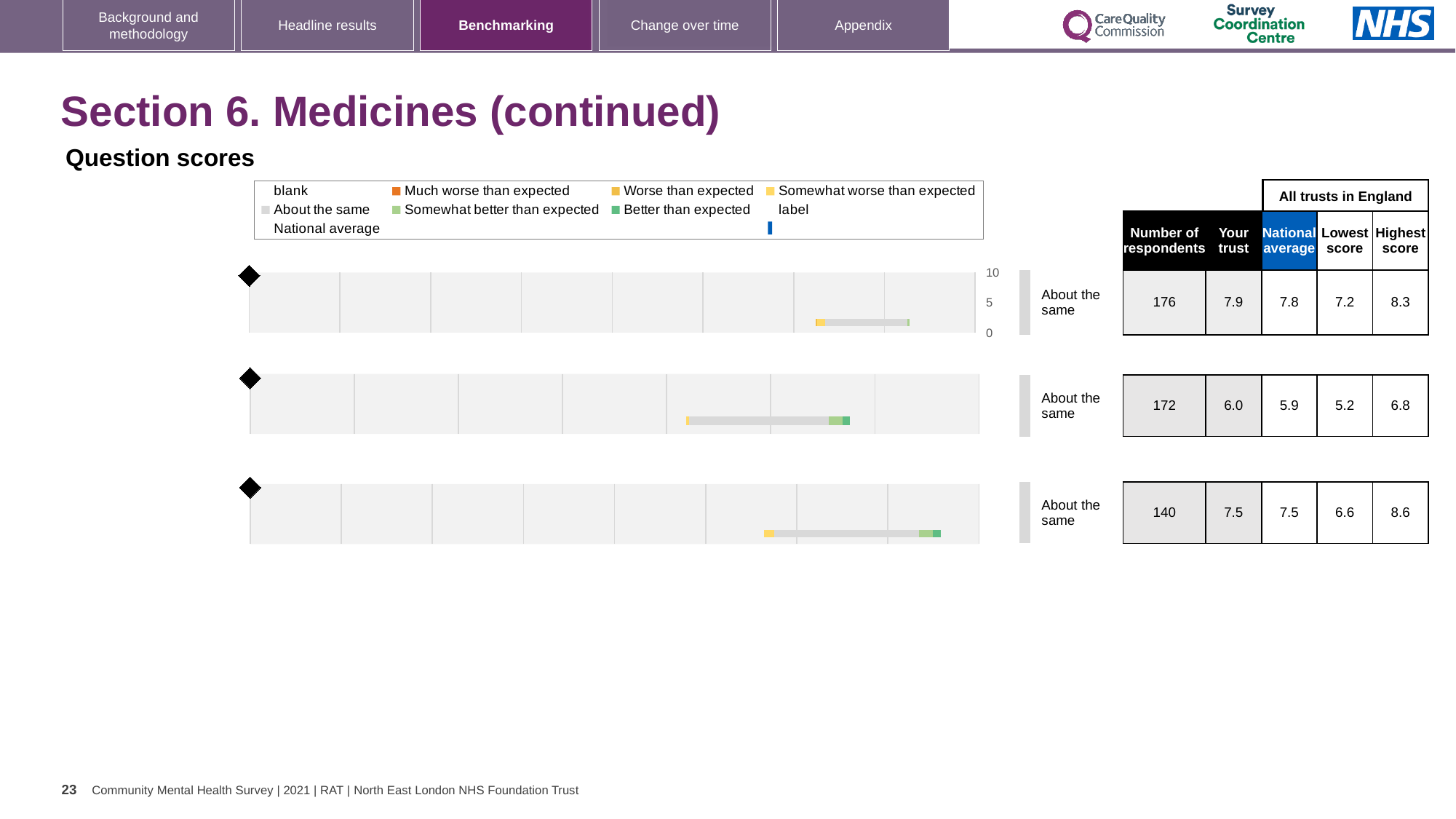
In the middle chart, what is the lowest score across all trusts in England? 5.2 In the bottom chart, what is the highest score across all trusts in England? 8.6 In the top chart, what is the 'Your trust' score? 7.9 In the middle chart, which is larger: the 'Your trust' score or the national average? Your trust Which of the three charts has the lowest 'Your trust' score? The middle chart In the middle chart, how many respondents are there? 172 In the top chart, what is the difference between the highest score and the lowest score? 1.1 What benchmark category label is shown next to each of the three charts? About the same What kind of chart is used on this slide? Bar chart How many charts are shown on the slide? 3 In the top chart, is the 'Your trust' score greater or less than 5? greater In the top chart, what is the national average score? 7.8